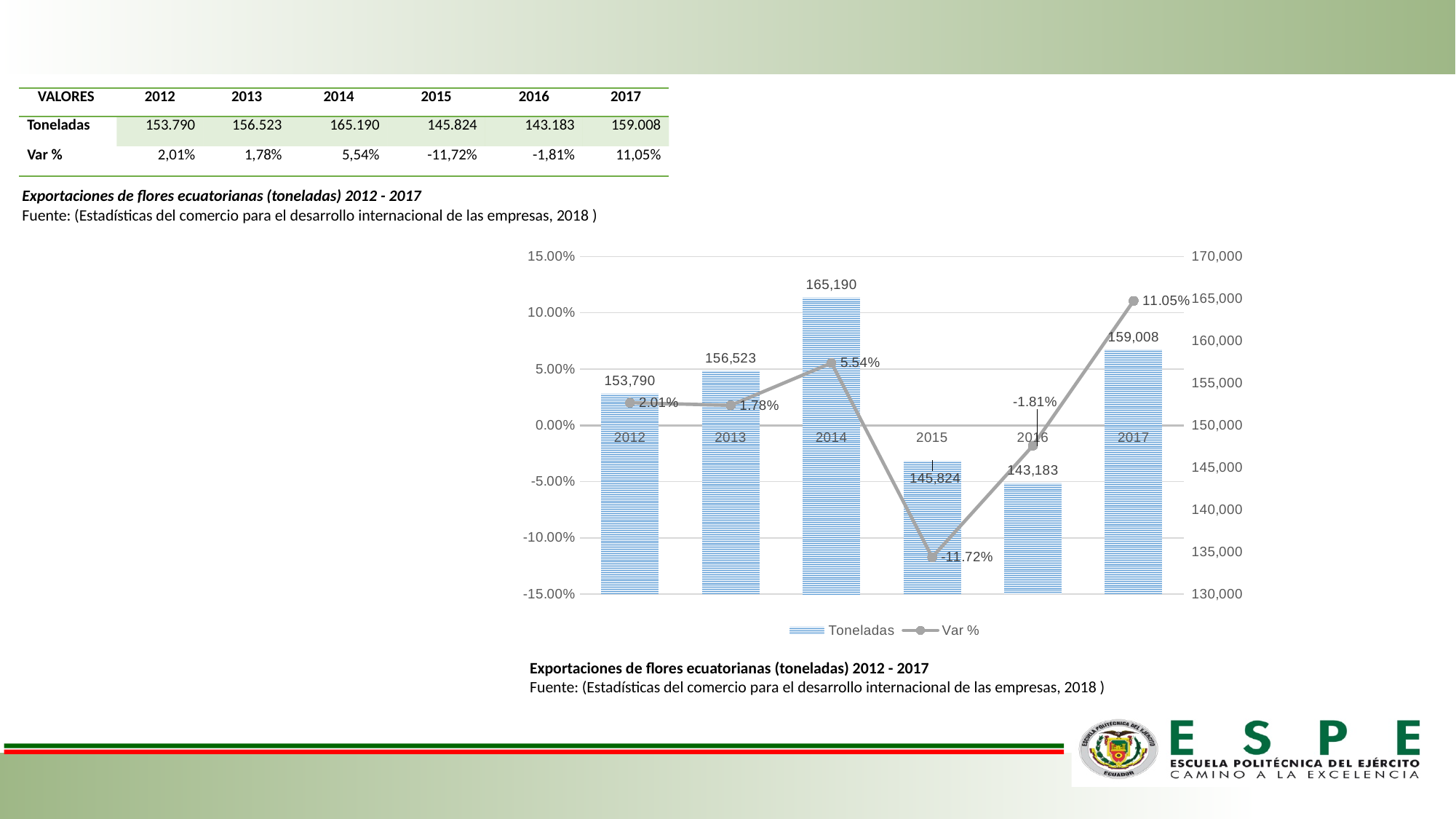
What is the Toneladas value for 2014? 165,190 What is the difference in Toneladas between 2014 and 2016? 22,007 What kind of chart is this? Combined bar and line chart How many series does the legend list? 2 Which is larger, the Toneladas value for 2013 or for 2015? 2013 Which year has the highest Toneladas value? 2014 Does the Var % line rise or fall from 2015 to 2017? Rise What is the Toneladas value for 2017? 159,008 Which year has the highest Var % value? 2017 How many years are shown on the x axis? 6 What is the Var % value for 2015? -11.72% Which year has the lowest Toneladas value? 2016